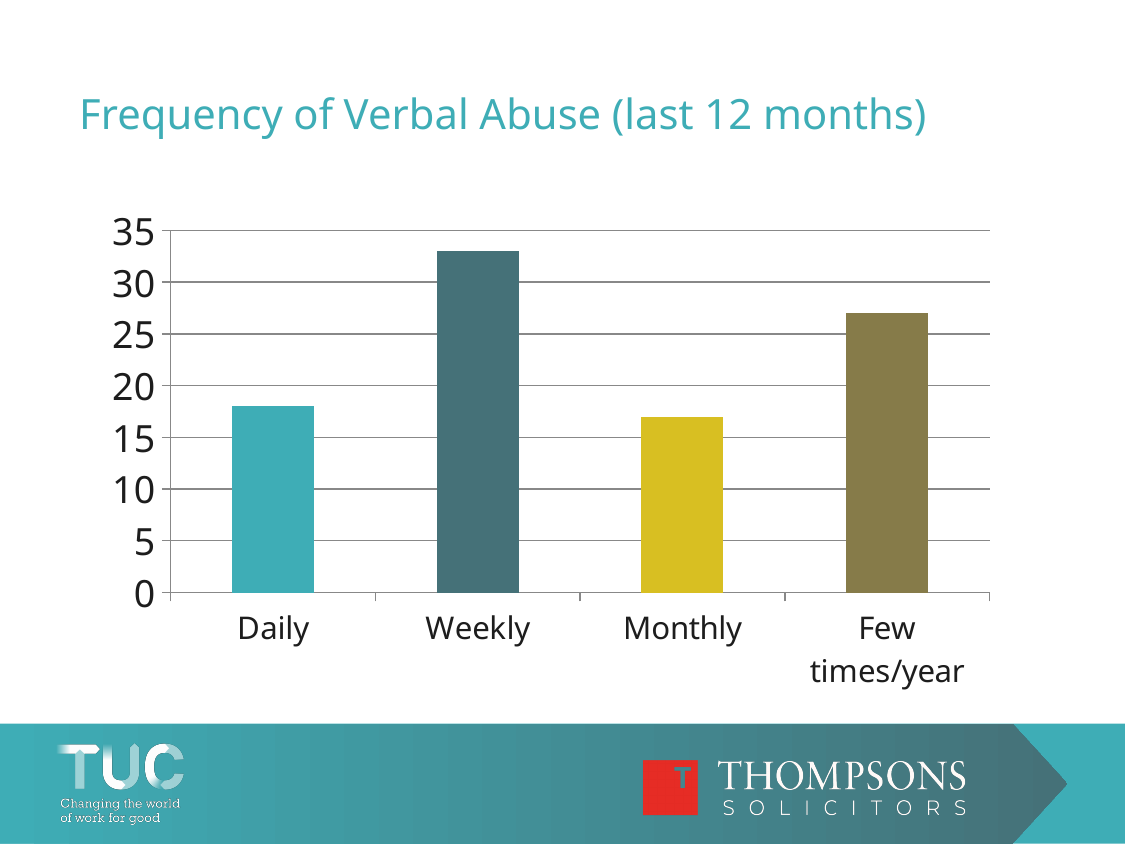
Which category has the highest value? Weekly How many categories are shown on the x axis? 4 Is the value for Daily greater or less than 15? greater Which is larger, the value for Few times/year or the value for Monthly? Few times/year Is the value for Daily greater or less than 20? less Is the value for Weekly greater or less than 30? greater Which is larger, the value for Weekly or the value for Few times/year? Weekly What kind of chart is shown on the slide? bar chart What is the title of the chart? Frequency of Verbal Abuse (last 12 months)